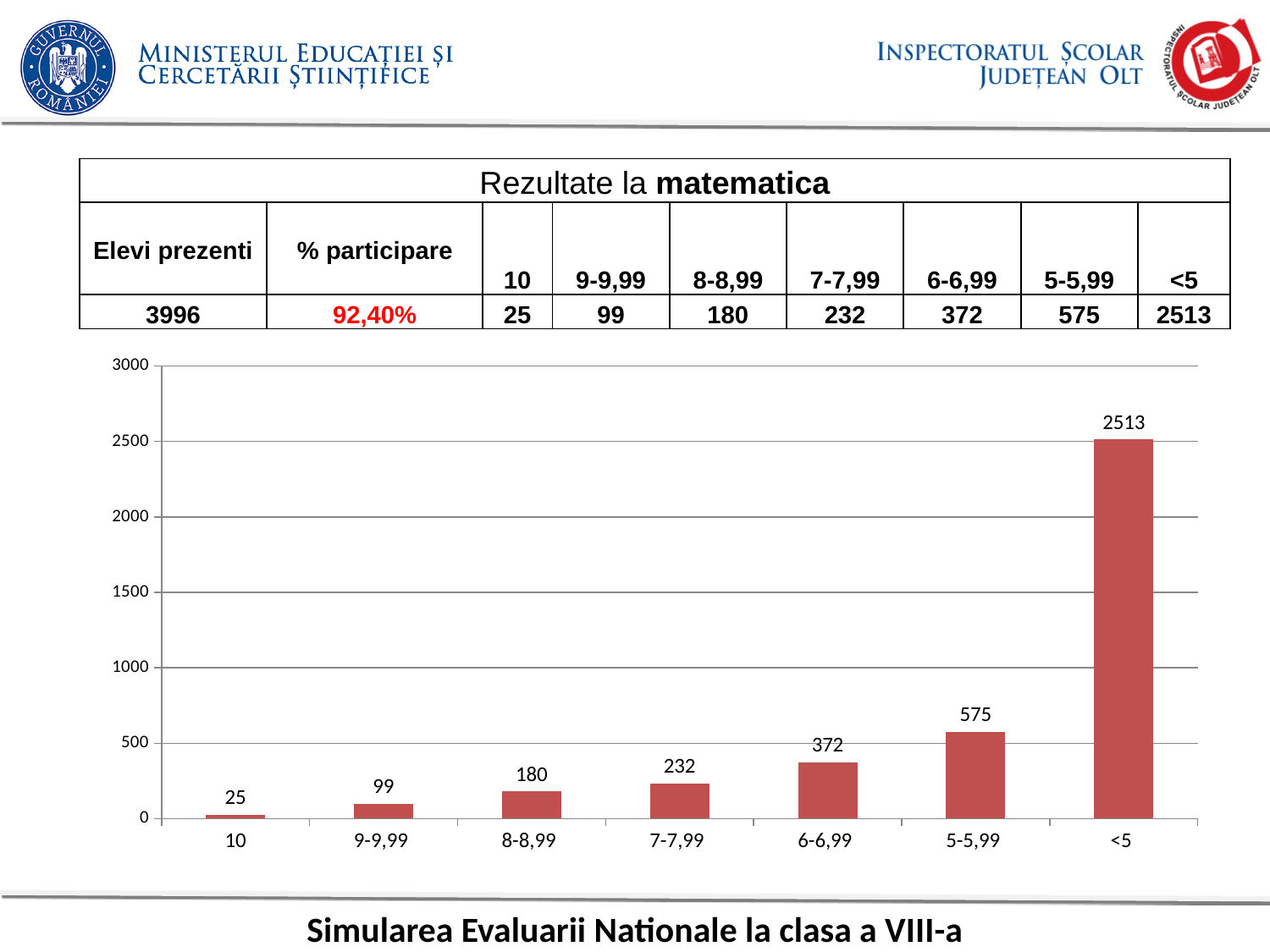
Which is larger, the value for "8-8,99" or the value for "7-7,99"? 7-7,99 Which category has the highest value? <5 Do the values rise or fall from left to right along the x axis? rise What is the difference between the values for "5-5,99" and "6-6,99"? 203 Which category has the lowest value? 10 What is the value for the "<5" category? 2513 What is the value for the "9-9,99" category? 99 Is the value for "5-5,99" greater or less than 500? greater What is the highest tick value shown on the y axis? 3000 What is the value for the "7-7,99" category? 232 How many categories are shown on the x axis? 7 What kind of chart is shown on the slide? bar chart